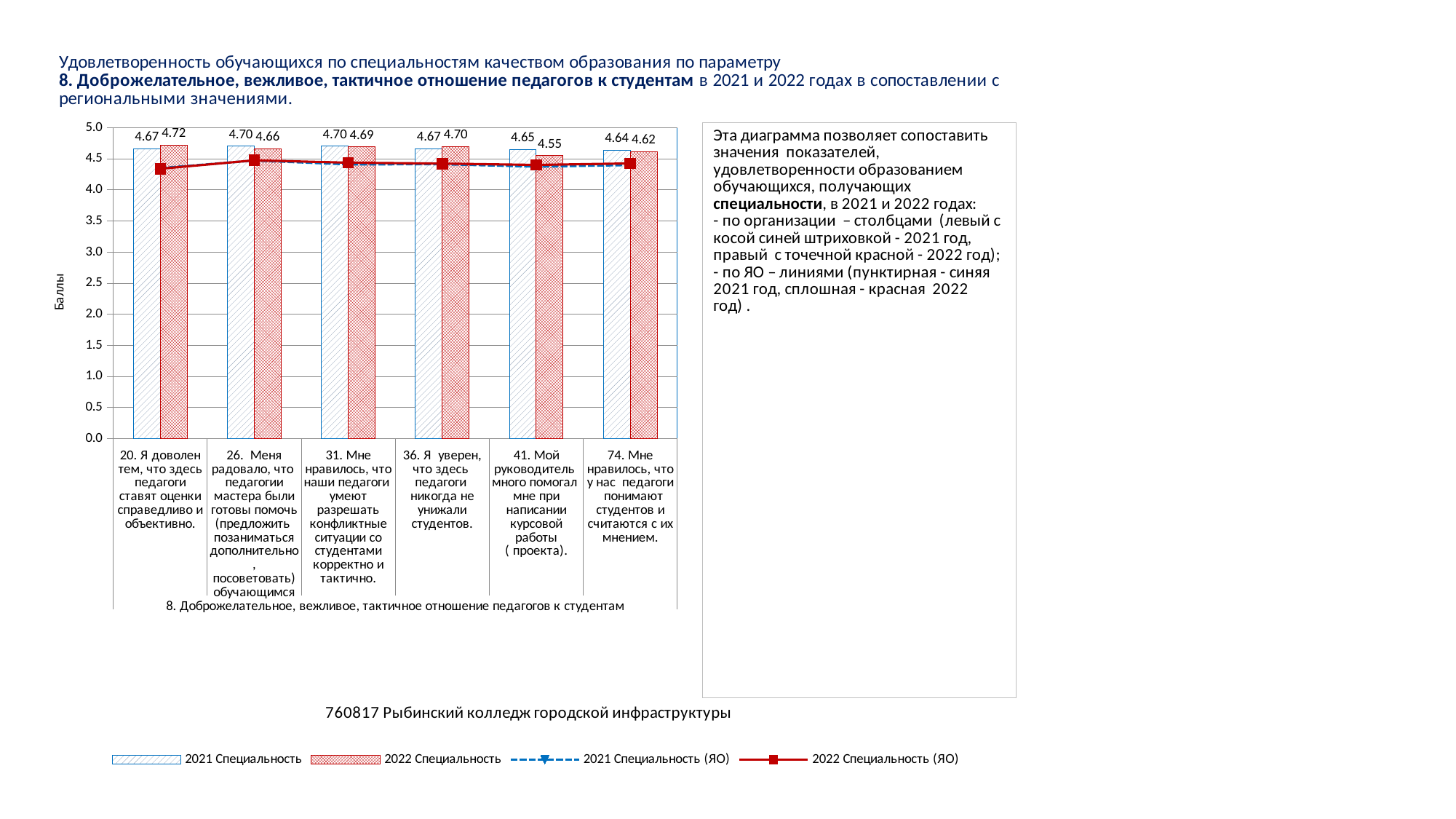
How many series does the chart legend list? 4 Is the 2022 Специальность (ЯО) line value for category 20 greater or less than 4.5? less How many categories are shown on the x axis of the chart? 6 What is the 2022 Специальность value for category 41 (Мой руководитель много помогал мне при написании курсовой работы)? 4.55 What is the 2021 Специальность value for category 20 (Я доволен тем, что здесь педагоги ставят оценки справедливо и объективно)? 4.67 Which category has the highest 2022 Специальность value? 20. Я доволен тем, что здесь педагоги ставят оценки справедливо и объективно. What is the difference between the 2021 and 2022 Специальность values for category 41? 0.10 What is the label of the vertical axis of the chart? Баллы What kind of chart is shown on the slide? Combined bar and line chart For category 26 (Меня радовало, что педагоги и мастера были готовы помочь), which is larger: the 2021 Специальность value or the 2022 Специальность value? 2021 Специальность What is the 2022 Специальность value for category 74 (Мне нравилось, что у нас педагоги понимают студентов и считаются с их мнением)? 4.62 Which category has the lowest 2022 Специальность value? 41. Мой руководитель много помогал мне при написании курсовой работы (проекта).